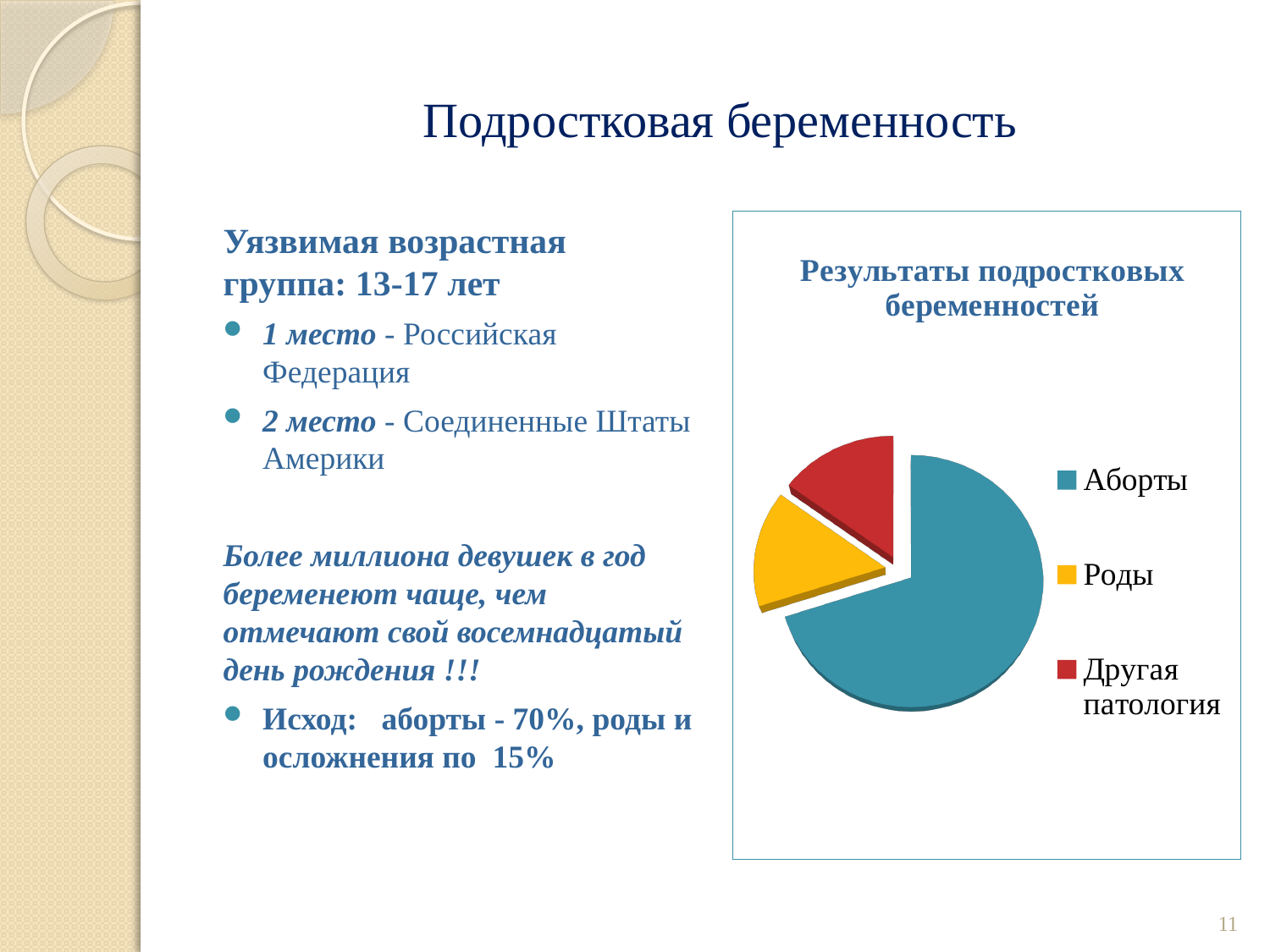
What is the title of the chart? Результаты подростковых беременностей What colour is the Аборты slice in the pie chart? blue How many slices does the pie chart have? 3 Which category has the largest slice of the pie? Аборты Which slice is larger, Аборты or Другая патология? Аборты Which slice is larger, Аборты or Роды? Аборты How many entries does the chart legend list? 3 According to the slide, what share of teenage pregnancies ends in abortion (Аборты)? 70% What kind of chart is shown on the slide? pie chart